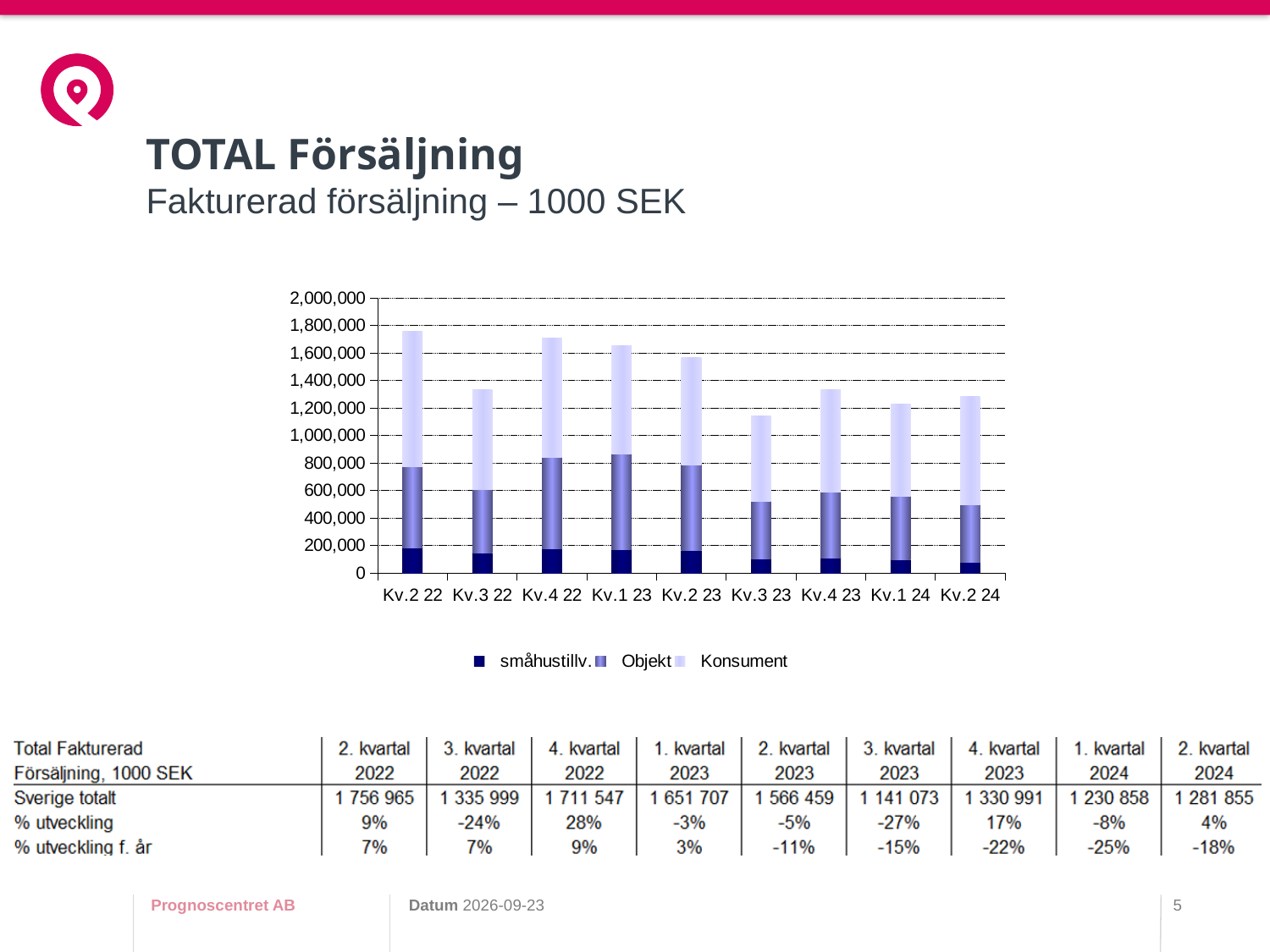
Which series are listed in the chart legend? småhustillv., Objekt, Konsument Is the total bar for Kv.3 23 greater or less than 1,200,000? less How many quarters are shown on the x axis of the chart? 9 Do the total bars generally rise or fall from Kv.2 22 to Kv.2 24? fall Which quarter has the lowest total bar in the chart? Kv.3 23 Which quarter has the highest total bar in the chart? Kv.2 22 What is the difference between the Sverige totalt values for 2. kvartal 2022 and 3. kvartal 2023 in the table? 615 892 What kind of chart is shown on the slide? Stacked bar chart How many series does the chart legend list? 3 According to the table, what is the total invoiced sales (Sverige totalt) for 2. kvartal 2024? 1 281 855 Is the total bar for Kv.2 22 greater or less than 1,600,000? greater Which total bar is larger, Kv.2 23 or Kv.4 23? Kv.2 23